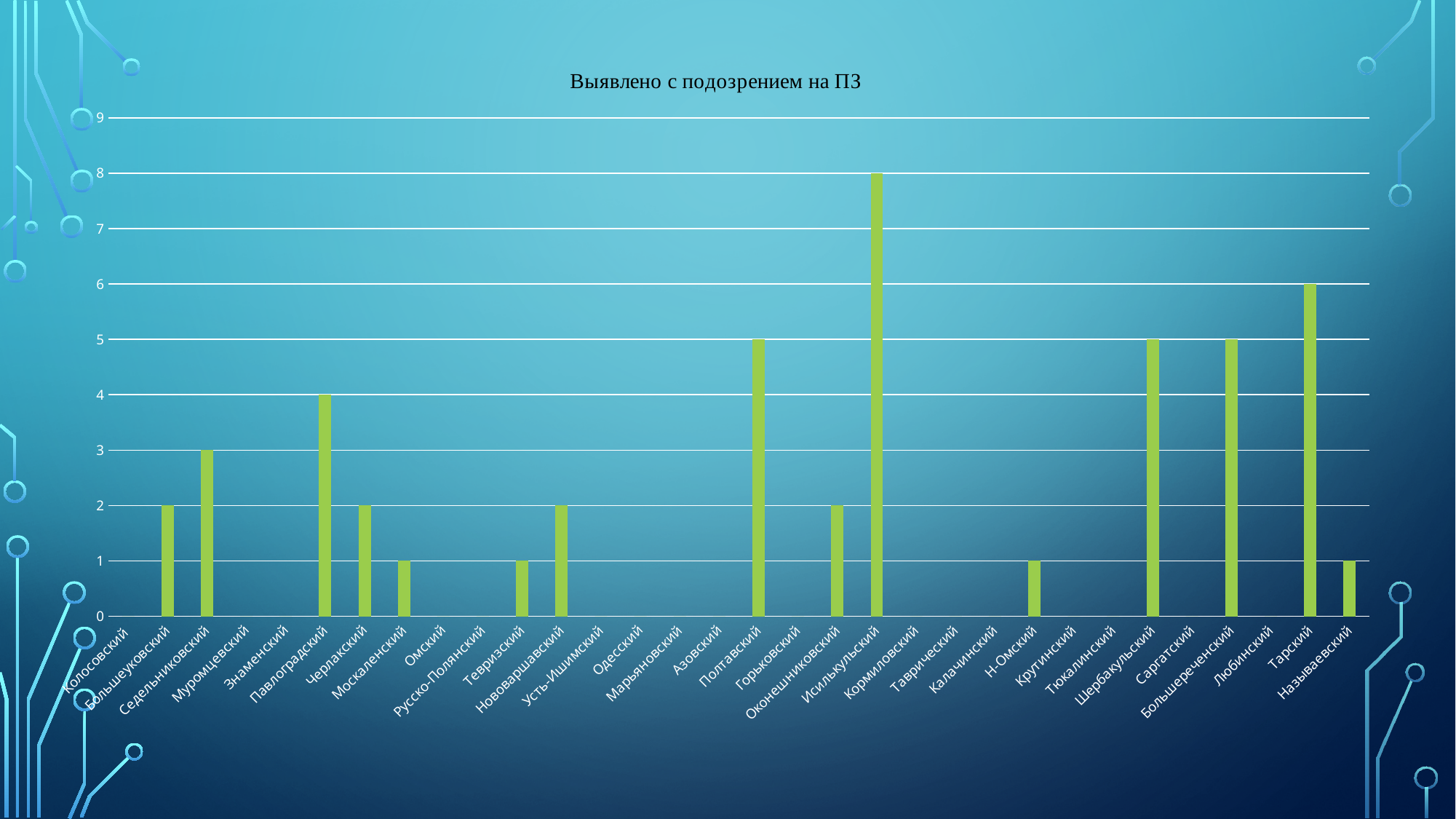
What is the value for Полтавский? 5 What is the value for Павлоградский? 4 What is the title of the chart? Выявлено с подозрением на ПЗ What kind of chart is shown on the slide? bar chart What is the difference between the values for Исилькульский and Тарский? 2 How many categories are shown on the x axis? 32 What is the value for Тарский? 6 What is the value for Исилькульский? 8 Which is larger, the value for Павлоградский or the value for Черлакский? Павлоградский What is the value for Седельниковский? 3 Is the value for Шербакульский greater or less than 4? greater Which category has the highest value? Исилькульский